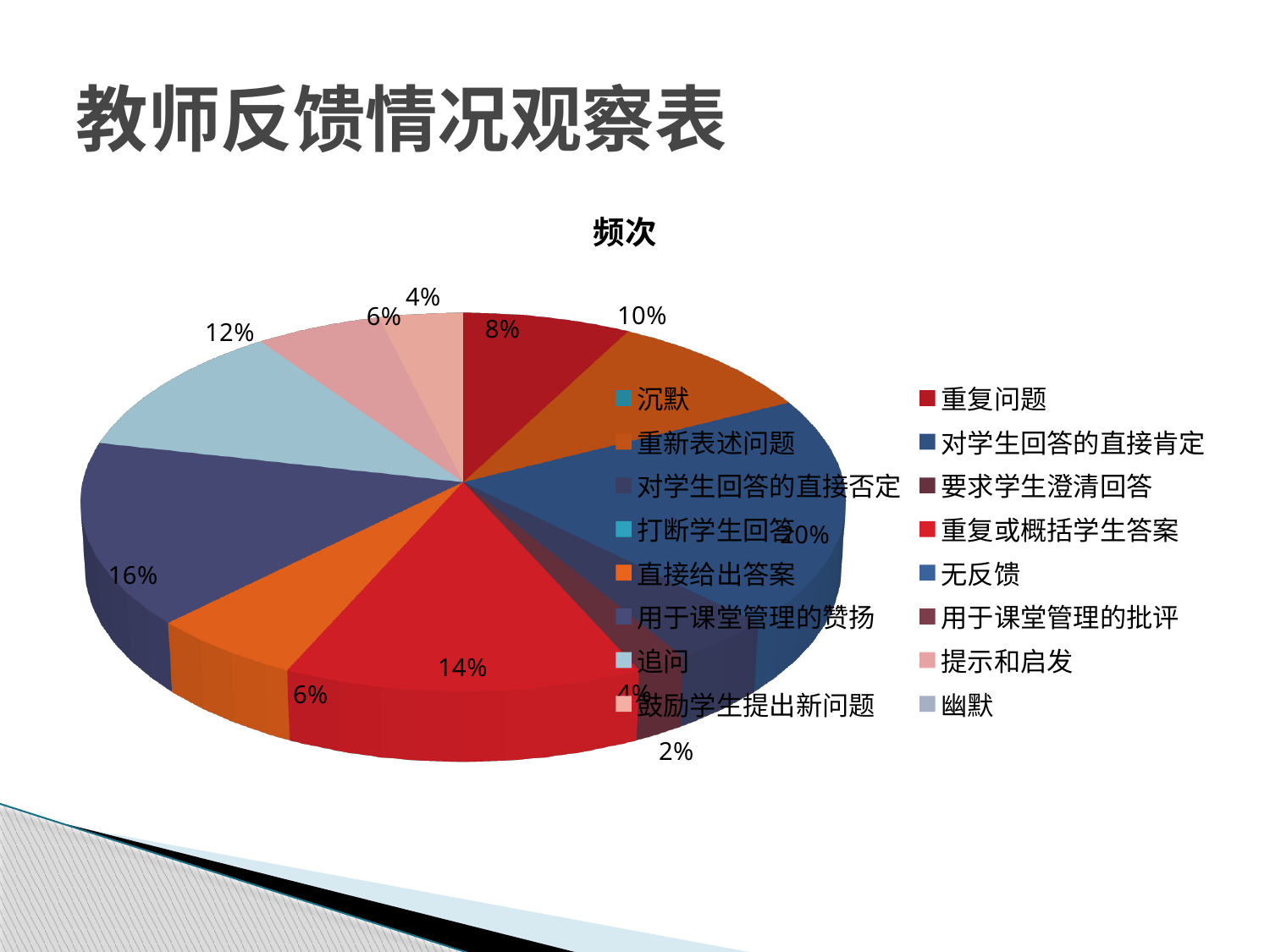
Which is larger, the 20% slice or the 14% slice? the 20% slice What share of the pie does 追问 (the light blue slice) have? 12% What is the largest percentage shown on any slice of the pie chart? 20% What is the smallest percentage labelled on the pie chart? 2% What is the title of the chart? 频次 What is the difference between the largest slice (20%) and the 16% slice? 4% What share of the pie does 重复或概括学生答案 (the red slice) have? 14% How many entries does the chart legend list? 16 What share of the pie does 对学生回答的直接肯定 (the dark blue slice) have? 20% What kind of chart is shown on the slide? pie chart Which legend entry is shown with a red colour swatch in the right-hand legend column? 重复或概括学生答案